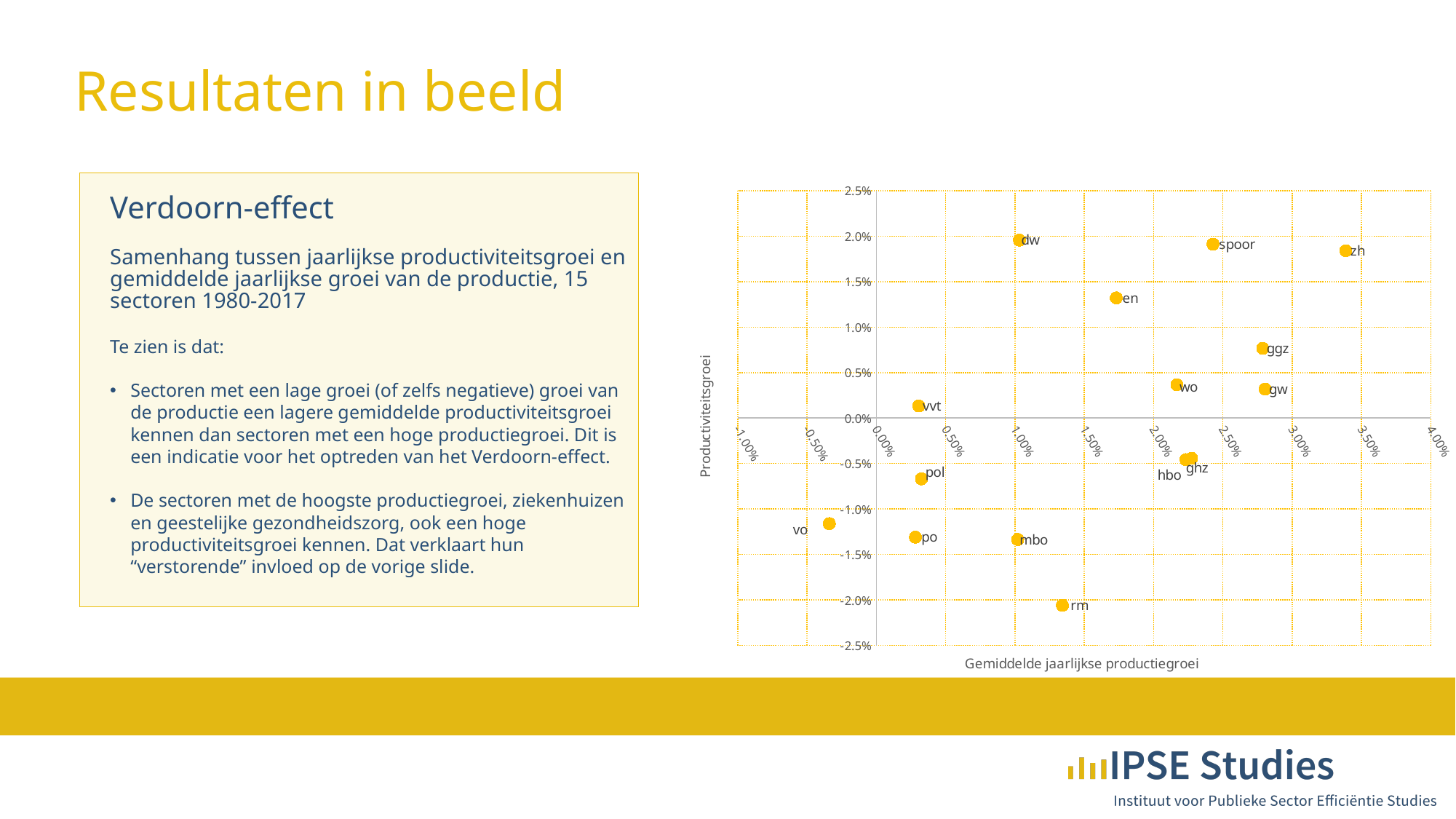
Is the productivity growth for ggz greater or less than 0.5%? greater Which sector has the lowest productivity growth (vertical axis) in the chart? rm Which sector has the higher productivity growth, ggz or gw? ggz What is the title of the horizontal axis of the chart? Gemiddelde jaarlijkse productiegroei Which sector has the highest average annual production growth (horizontal axis) in the chart? zh Is the productivity growth for mbo greater or less than -1.0%? less How many labelled data points are plotted in the chart? 15 What is the title of the vertical axis of the chart? Productiviteitsgroei Which sector has the lowest average annual production growth (horizontal axis) in the chart? vo Is the average annual production growth for zh greater or less than 3.00%? greater What kind of chart is shown on the slide? scatter chart